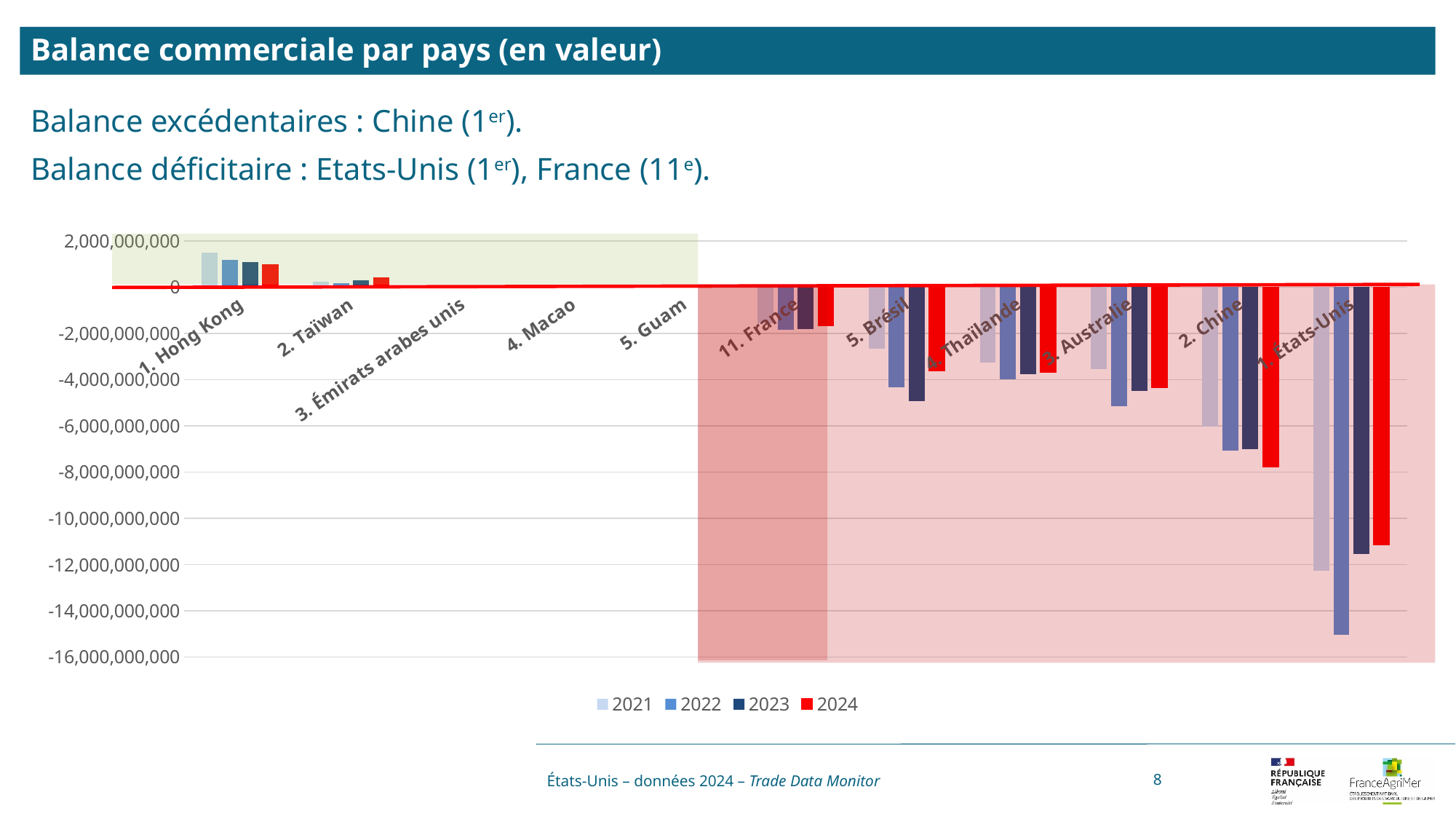
Is the 2022 value for 1. États-Unis greater or less than -14,000,000,000? less How many countries (categories) are shown on the x axis of the chart? 11 Which is lower, the 2023 value for 5. Brésil or the 2023 value for 4. Thaïlande? 5. Brésil Which is lower, the 2024 value for 2. Chine or the 2024 value for 5. Brésil? 2. Chine Is the 2024 value for 2. Chine greater or less than -6,000,000,000? less Is the 2024 value for 11. France greater or less than -2,000,000,000? greater Which country has the highest (most positive) bars in the chart? 1. Hong Kong What kind of chart is shown on the slide? bar chart How many series does the chart legend list? 4 Which country and year has the lowest (most negative) value in the chart? 1. États-Unis, 2022 Which colour represents the 2024 series in the chart legend? red